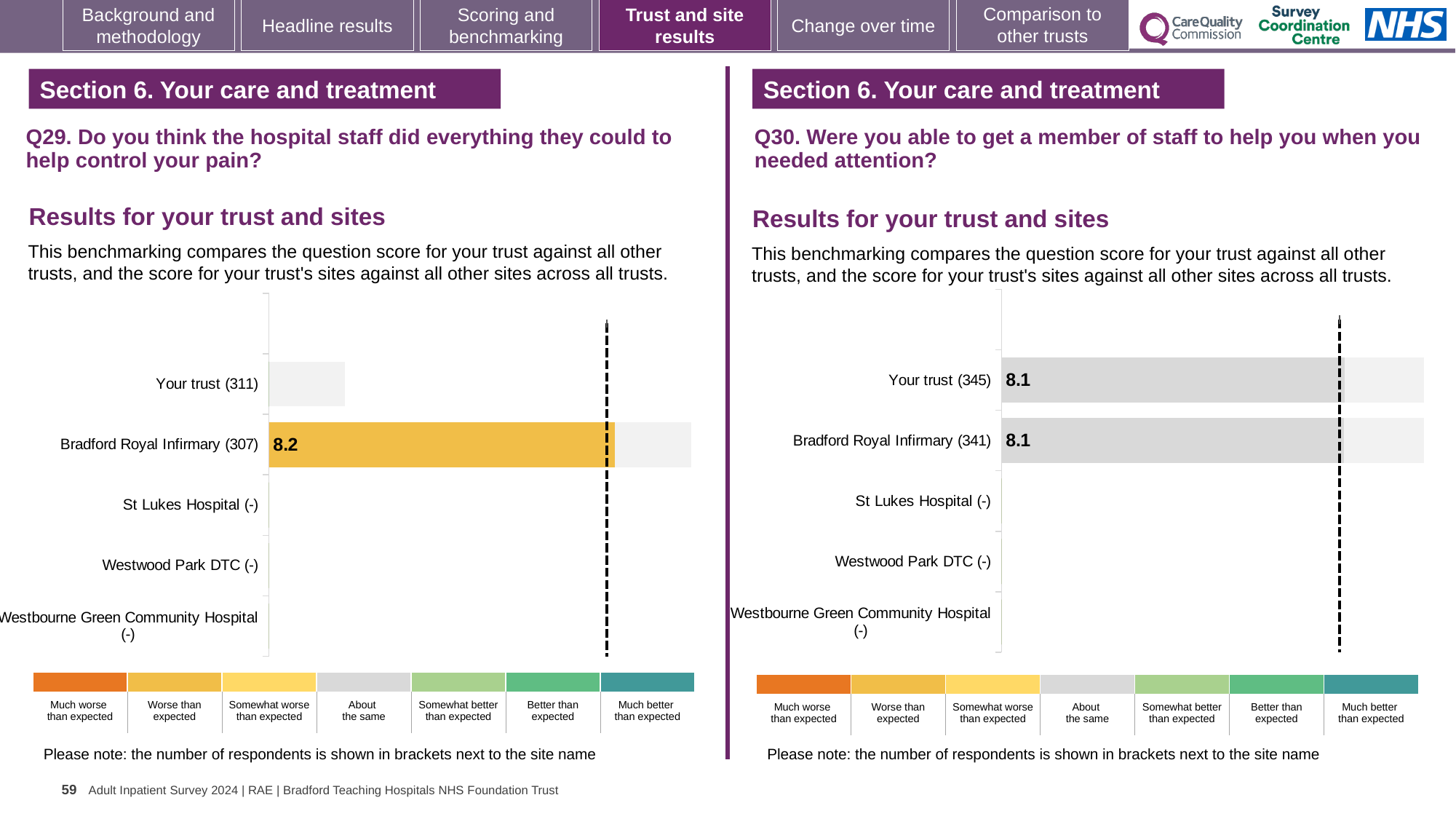
In the Q29 chart on the left, what is the score shown for Bradford Royal Infirmary (307)? 8.2 How many site/trust categories are listed on the y axis of the Q29 chart on the left? 5 In the Q29 chart on the left, which benchmark category does the colour of the Bradford Royal Infirmary bar correspond to in the legend? Worse than expected How many site/trust categories are listed on the y axis of the Q30 chart on the right? 5 In the Q30 chart on the right, how many respondents are shown in brackets for Bradford Royal Infirmary? 341 In the Q29 chart on the left, how many respondents are shown in brackets for Your trust? 311 How many benchmark categories are shown in the colour legend below the Q30 chart on the right? 7 In the Q30 chart on the right, what is the score shown for Bradford Royal Infirmary (341)? 8.1 In the Q30 chart on the right, which benchmark category does the colour of the Your trust bar correspond to in the legend? About the same What is the difference between the Bradford Royal Infirmary score in the Q29 chart on the left (8.2) and in the Q30 chart on the right (8.1)? 0.1 In the Q30 chart on the right, what is the score shown for Your trust (345)? 8.1 What kind of chart is used in the Q29 chart on the left? Bar chart